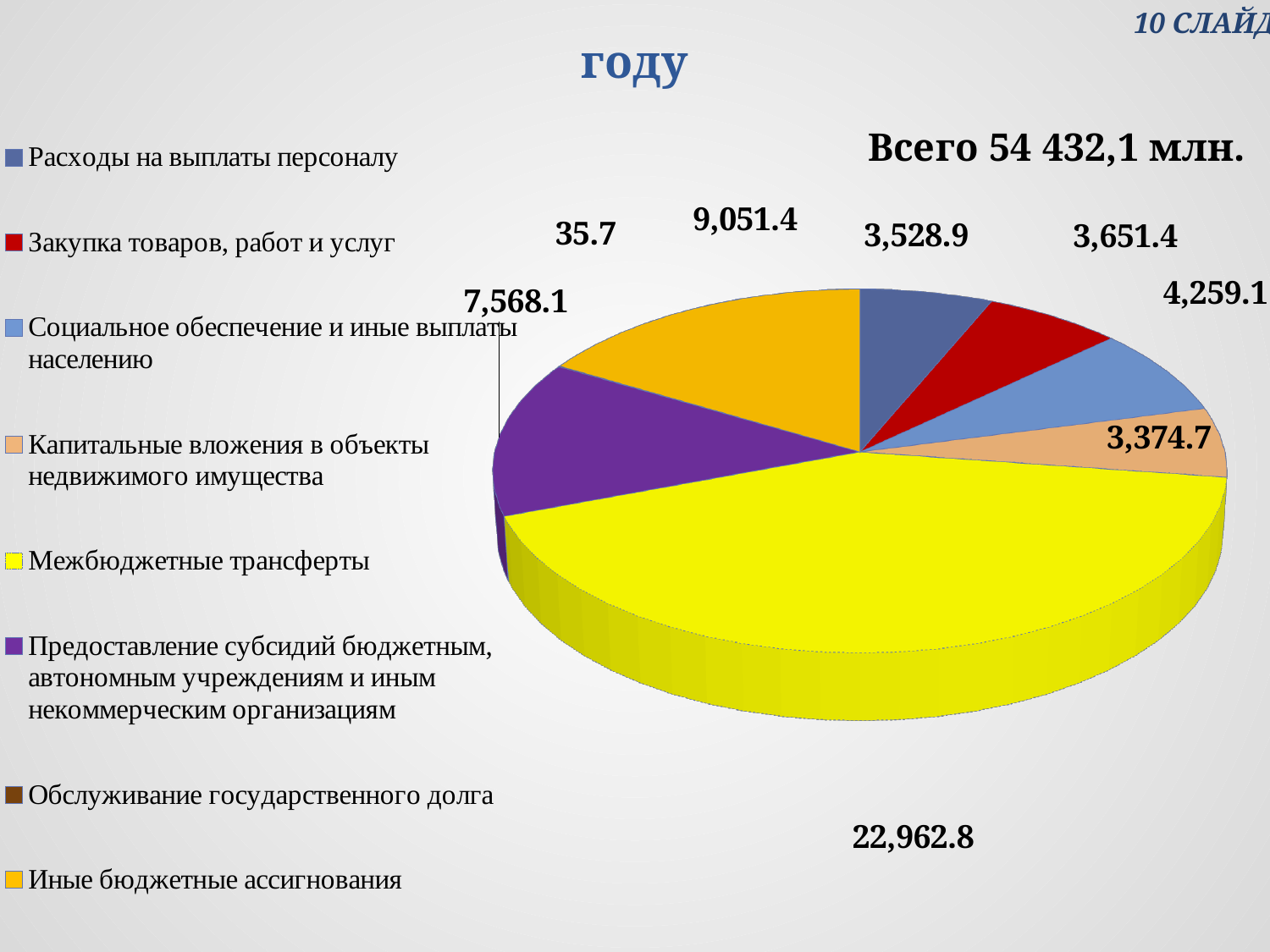
Which is larger: Закупка товаров, работ и услуг or Расходы на выплаты персоналу? Закупка товаров, работ и услуг What total is stated on the slide for all categories? 54 432,1 млн. What is the value for Иные бюджетные ассигнования? 9,051.4 What is the value for Межбюджетные трансферты? 22,962.8 What colour is the slice for Межбюджетные трансферты? Yellow Which category has the largest slice of the pie? Межбюджетные трансферты What is the value for Предоставление субсидий бюджетным, автономным учреждениям и иным некоммерческим организациям? 7,568.1 What is the difference between Иные бюджетные ассигнования and Предоставление субсидий бюджетным, автономным учреждениям и иным некоммерческим организациям? 1,483.3 How many categories does the legend list? 8 Which category has the smallest slice of the pie? Обслуживание государственного долга What is the value for Обслуживание государственного долга? 35.7 What type of chart is shown on the slide? Pie chart